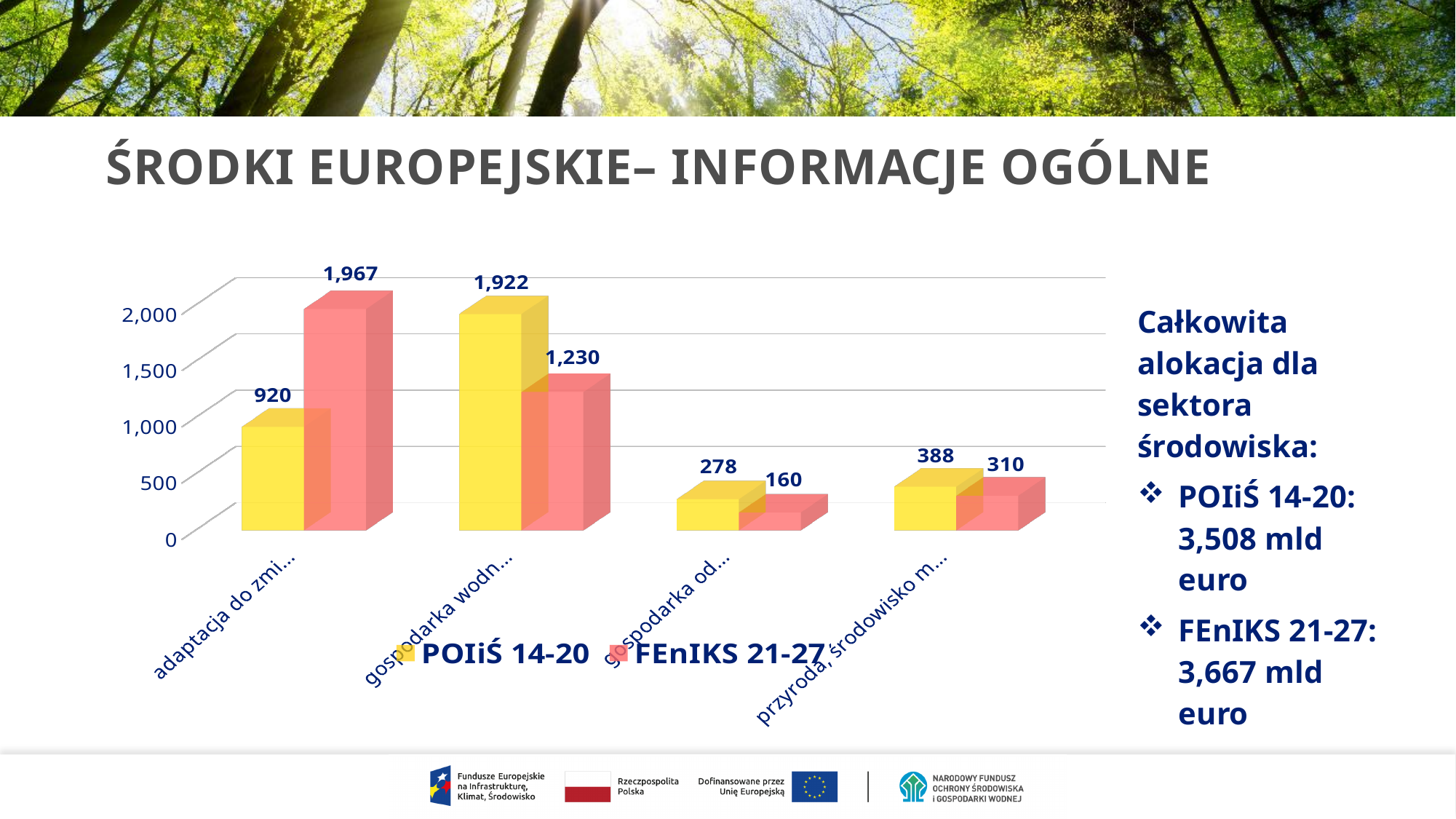
What is the value for FEnIKS 21-27 in the third category ("gospodarka od...")? 160 How many categories are shown on the x axis of the chart? 4 What is the value for FEnIKS 21-27 in the first category ("adaptacja do zmi...")? 1,967 What is the value for POIiŚ 14-20 in the second category ("gospodarka wodn...")? 1,922 What is the difference between the FEnIKS 21-27 and POIiŚ 14-20 values in the first category ("adaptacja do zmi...")? 1,047 Which category has the lowest value for the FEnIKS 21-27 series? gospodarka od... What is the value for POIiŚ 14-20 in the first category ("adaptacja do zmi...")? 920 What type of chart is shown on the slide? bar chart How many series does the chart legend list? 2 Which category has the highest value for the POIiŚ 14-20 series? gospodarka wodn... In the fourth category ("przyroda, środowisko m..."), which series has the larger value, POIiŚ 14-20 or FEnIKS 21-27? POIiŚ 14-20 Which colour represents the FEnIKS 21-27 series in the chart? red